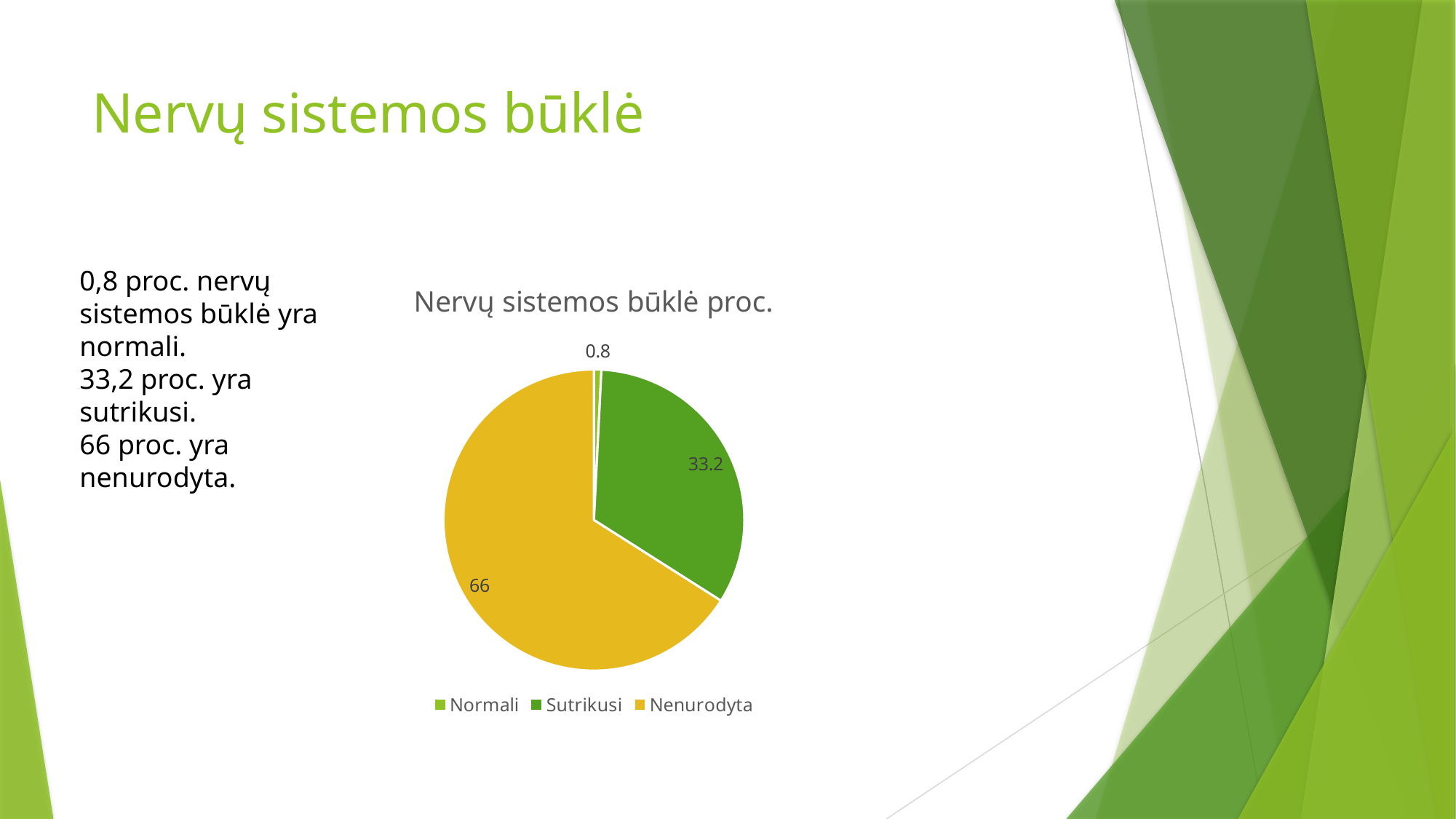
How many categories does the pie chart have? 3 What type of chart is shown on the slide? pie chart Which category has the smallest slice? Normali What is the value for Sutrikusi? 33.2 What is the title of the chart? Nervų sistemos būklė proc. What is the difference between the values for Nenurodyta and Sutrikusi? 32.8 What colour is the Nenurodyta slice? yellow Which category has the largest slice? Nenurodyta What is the value for Nenurodyta? 66 How many entries does the legend list? 3 Which is larger, the value for Sutrikusi or the value for Normali? Sutrikusi What is the value for Normali? 0.8